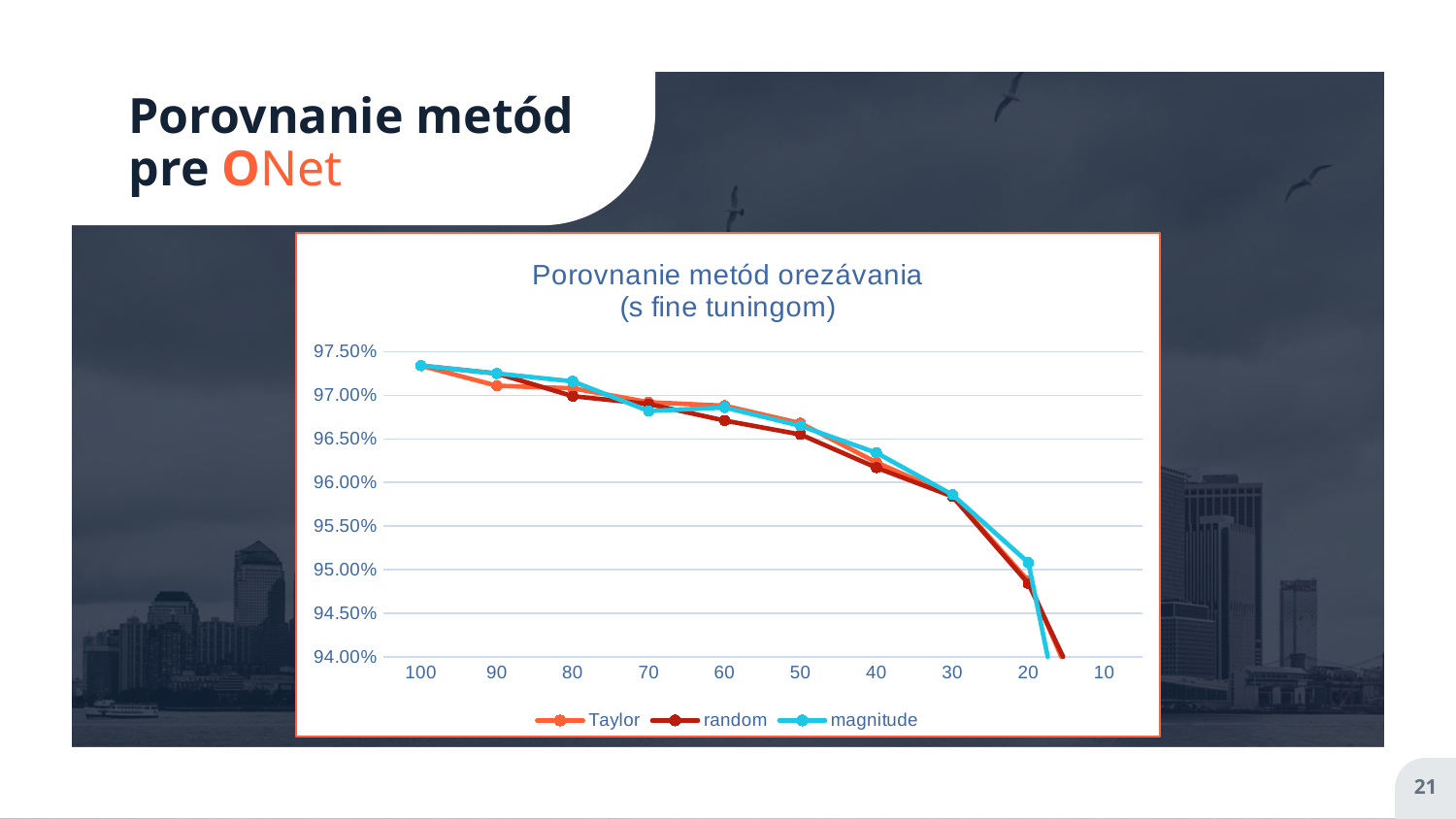
Is the value for the random series at x = 60 greater or less than 96.50%? greater Is the value for the magnitude series at x = 70 greater or less than 97.00%? less How many series does the chart legend list? 3 Is the value for the magnitude series at x = 40 greater or less than 96.50%? less What kind of chart is shown on the slide? line chart What are the names of the series in the chart legend? Taylor, random, magnitude Do the values of the series rise or fall as the x axis goes from 100 to 10? fall At x = 20, which series has the higher value, magnitude or random? magnitude How many tick labels are shown on the x axis? 10 What is the title of the chart? Porovnanie metód orezávania (s fine tuningom) At which x-axis value do all three series reach their highest values? 100